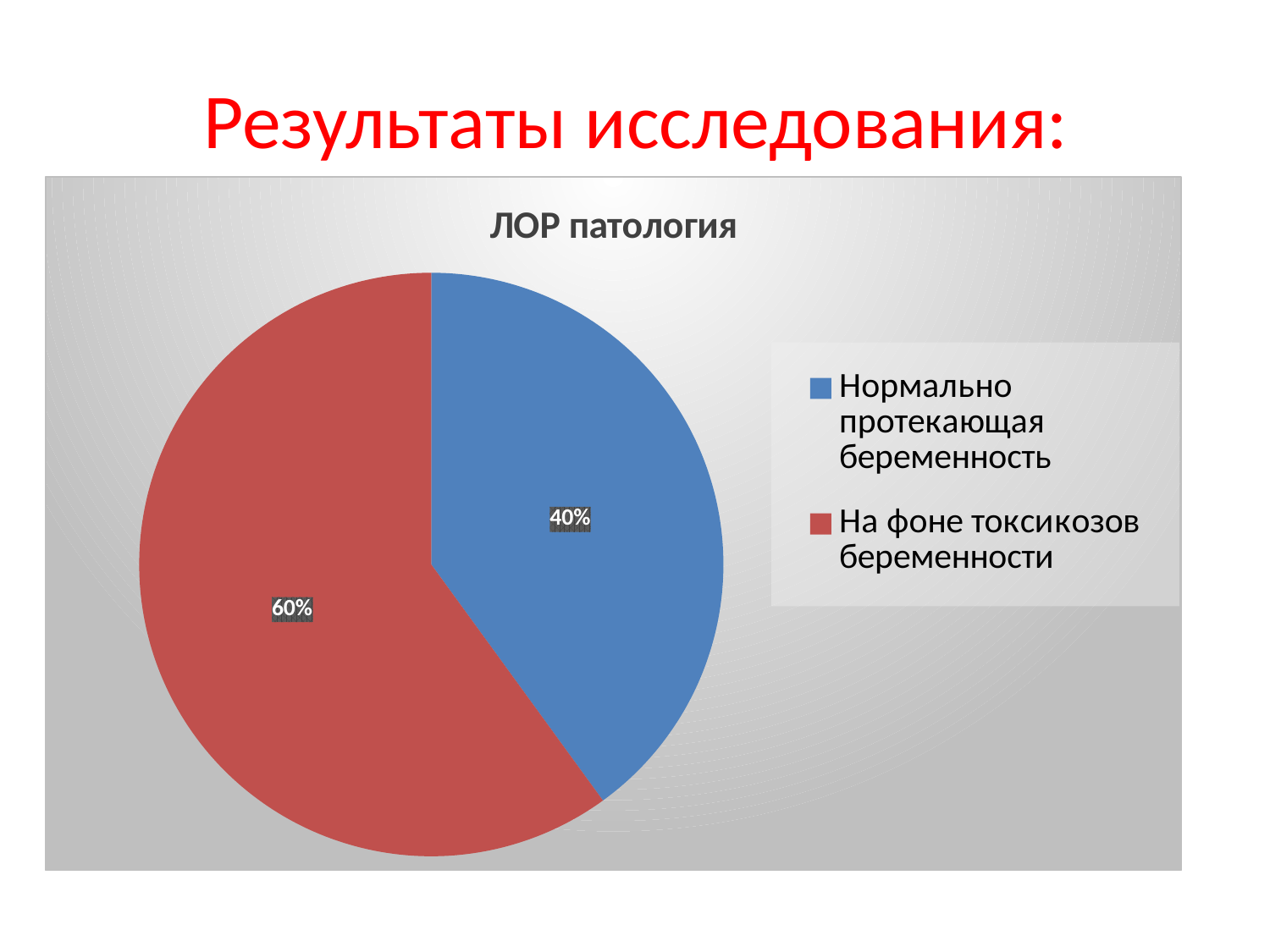
What colour is the slice for 'На фоне токсикозов беременности'? Red How many entries does the legend list? 2 What share of the pie does the blue slice represent? 40% How many slices does the pie chart have? 2 What percentage is shown for 'На фоне токсикозов беременности'? 60% What is the title of the chart? ЛОР патология What percentage is shown for 'Нормально протекающая беременность'? 40% Which category has the largest share of the pie? На фоне токсикозов беременности What is the difference in percentage points between 'На фоне токсикозов беременности' and 'Нормально протекающая беременность'? 20% Which category has the smallest share of the pie? Нормально протекающая беременность What type of chart is shown on the slide? Pie chart Which is larger: the share for 'Нормально протекающая беременность' or for 'На фоне токсикозов беременности'? На фоне токсикозов беременности